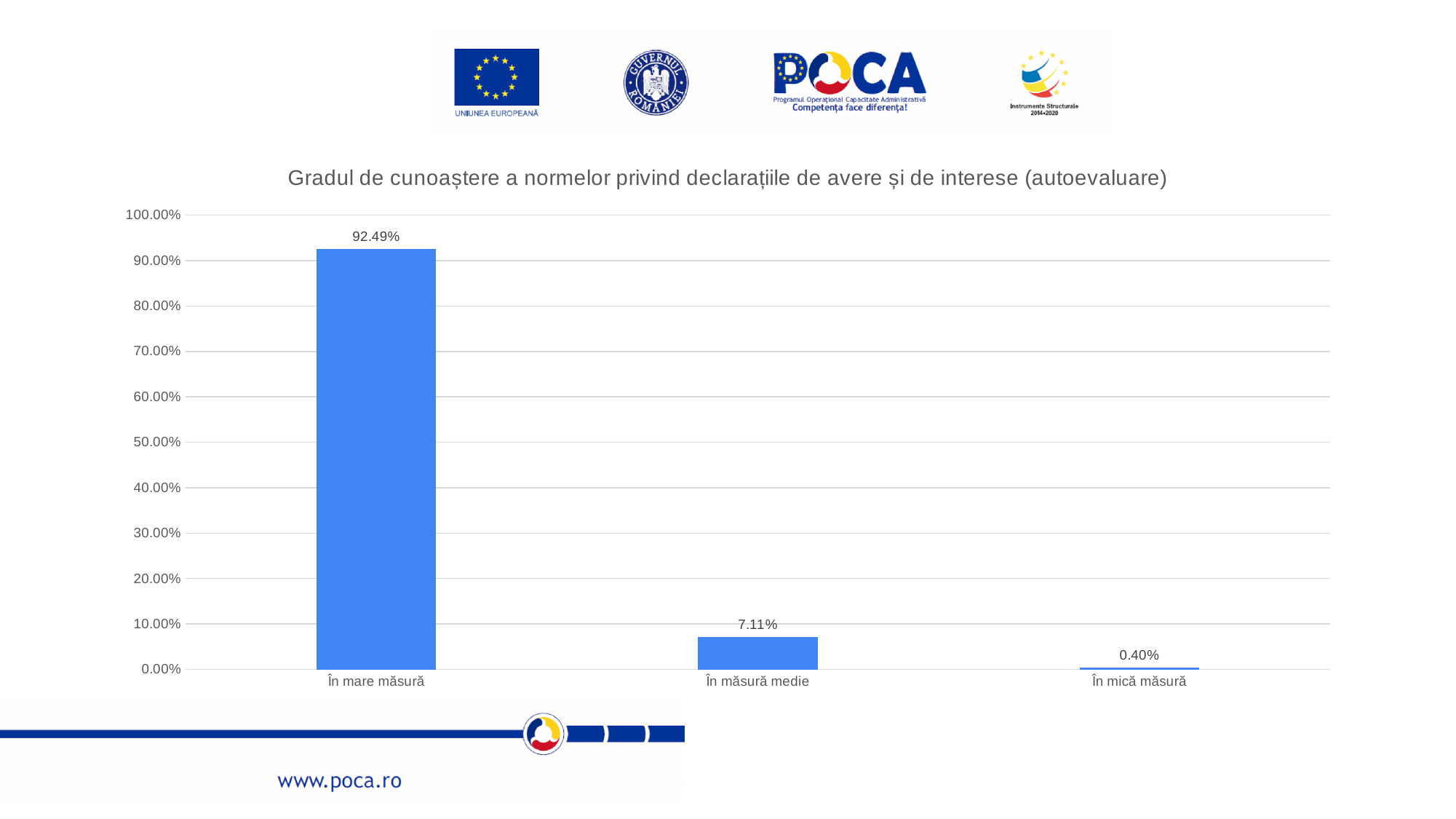
Which is larger, the value for "În măsură medie" or the value for "În mică măsură"? În măsură medie How many categories are shown on the x axis? 3 Which category has the highest value? În mare măsură What is the difference between the values for "În mare măsură" and "În măsură medie"? 85.38% What is the value for "În mare măsură"? 92.49% Is the value for "În mare măsură" greater or less than 90.00%? greater What is the title of the chart? Gradul de cunoaștere a normelor privind declarațiile de avere și de interese (autoevaluare) What is the value for "În mică măsură"? 0.40% What kind of chart is shown on the slide? bar chart What is the difference between the values for "În măsură medie" and "În mică măsură"? 6.71% What is the value for "În măsură medie"? 7.11% Which category has the lowest value? În mică măsură